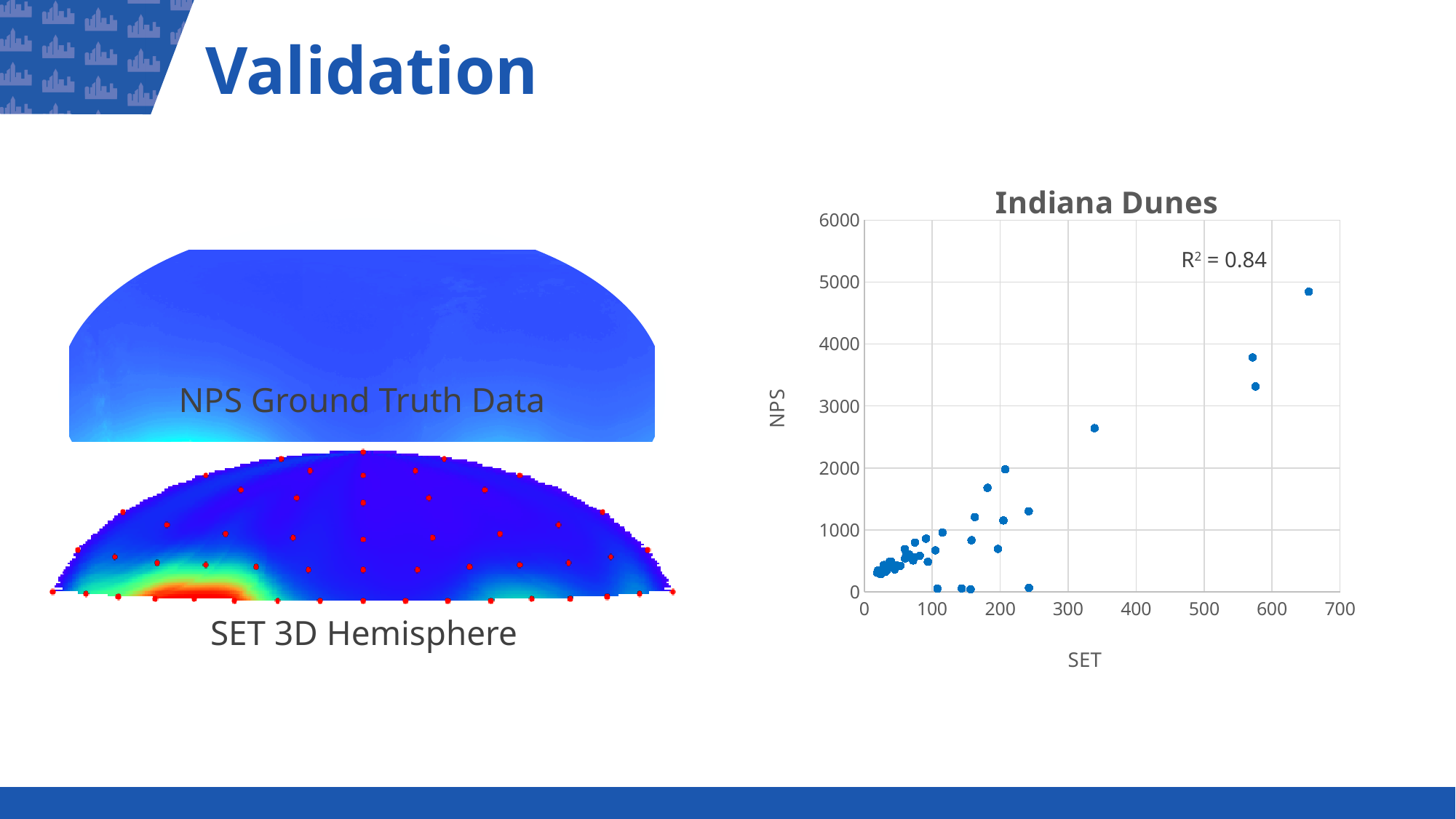
In the Indiana Dunes chart, which has the higher NPS: the point near SET 340 or the point near SET 570? the point near SET 570 In the Indiana Dunes chart, is the NPS value of the point near SET 340 greater or less than 2000? greater In the Indiana Dunes chart, is the highest NPS value plotted greater or less than 5000? less In the Indiana Dunes chart, is the NPS value of the point near SET 100 with the lowest NPS greater or less than 1000? less In the Indiana Dunes chart, how many points have a SET value greater than 300? 4 In the Indiana Dunes chart, do NPS values generally rise or fall as SET increases? rise What is the title of the chart on the right of the slide? Indiana Dunes What R² value is printed on the Indiana Dunes chart? 0.84 In the Indiana Dunes chart, how many points have a SET value greater than 500? 3 What kind of chart is the Indiana Dunes chart? scatter chart